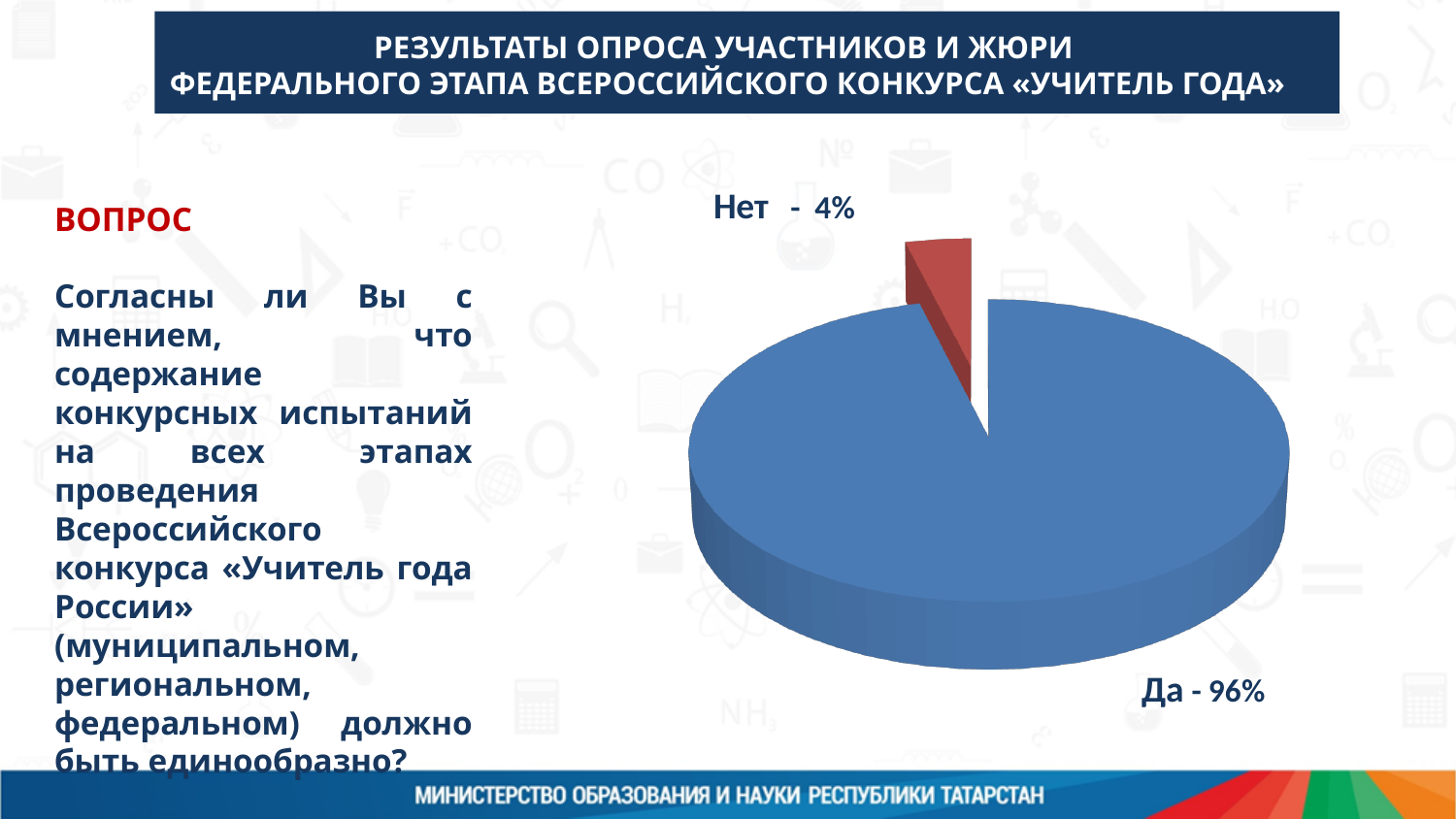
What colour is the "Нет" slice? red What is the total of the two slice percentages shown? 100% What share of respondents answered "Да"? 96% What kind of chart is shown on the slide? pie chart Which is larger, the share for "Да" or the share for "Нет"? Да What colour is the "Да" slice? blue How many slices does the pie chart have? 2 Which answer has the largest share of the pie? Да What share of respondents answered "Нет"? 4% What is the difference in percentage points between the "Да" and "Нет" shares? 92 Which answer has the smallest share of the pie? Нет